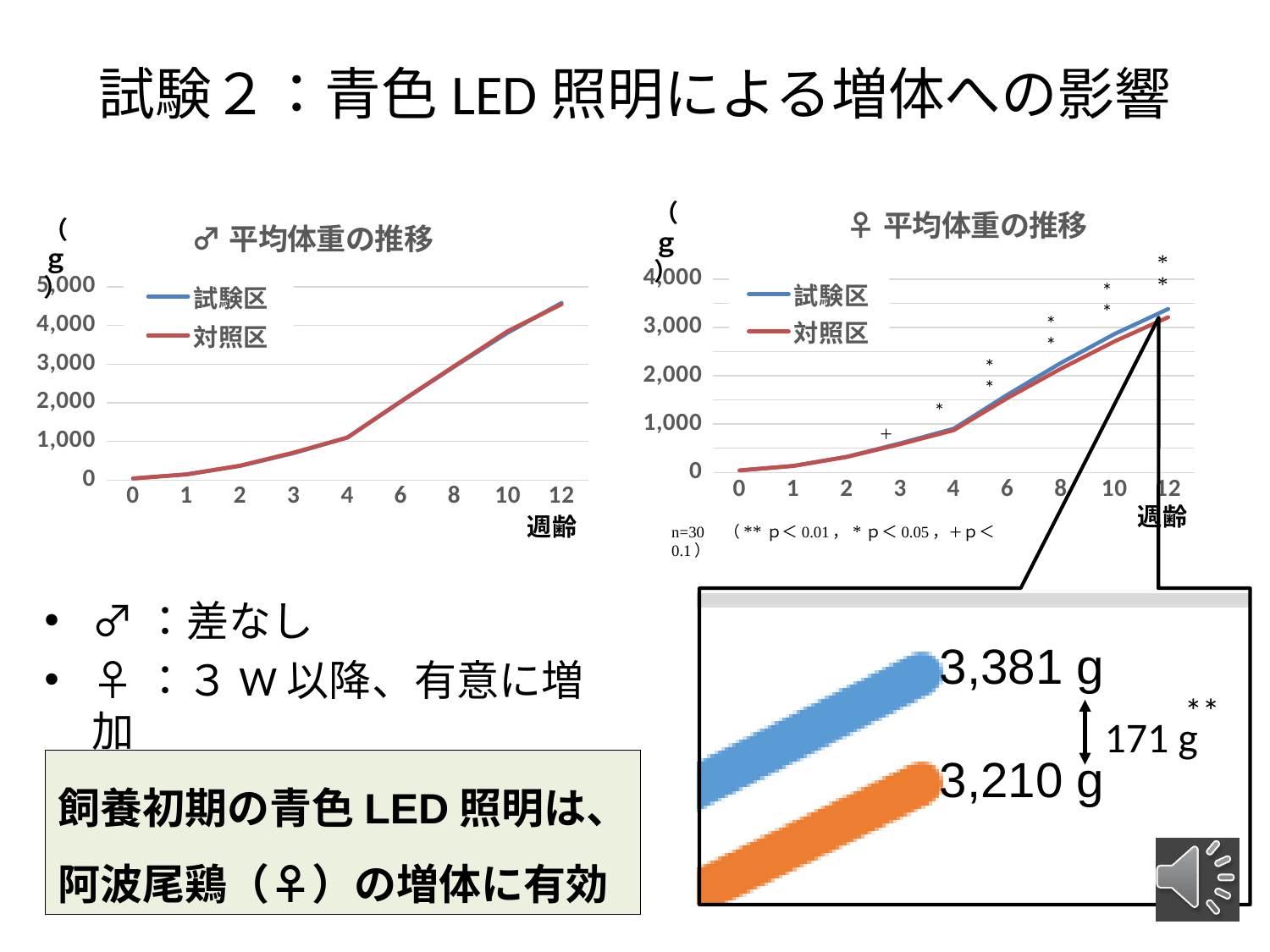
How many week-age points are shown on the x axis of the ♂ 平均体重の推移 chart? 9 In the ♀ 平均体重の推移 chart, which series is larger at week 12, 試験区 or 対照区? 試験区 In the ♀ 平均体重の推移 chart, what colour is the 試験区 line? blue In the ♀ 平均体重の推移 chart, what is the value for 対照区 at week 12? 3,210 g How many series does the legend of the ♀ 平均体重の推移 chart list? 2 In the ♀ 平均体重の推移 chart, what is the value for 試験区 at week 12? 3,381 g In the ♂ 平均体重の推移 chart, is the value for 試験区 at week 12 greater or less than 4,000? greater In the ♂ 平均体重の推移 chart, is the value for 対照区 at week 2 greater or less than 1,000? less In the ♀ 平均体重の推移 chart, is the value for 試験区 at week 4 greater or less than 1,000? less In the ♀ 平均体重の推移 chart, what is the difference between 試験区 and 対照区 at week 12? 171 g What kind of chart is the ♂ 平均体重の推移 chart? line chart In the ♂ 平均体重の推移 chart, do the values rise or fall as 週齢 increases? rise